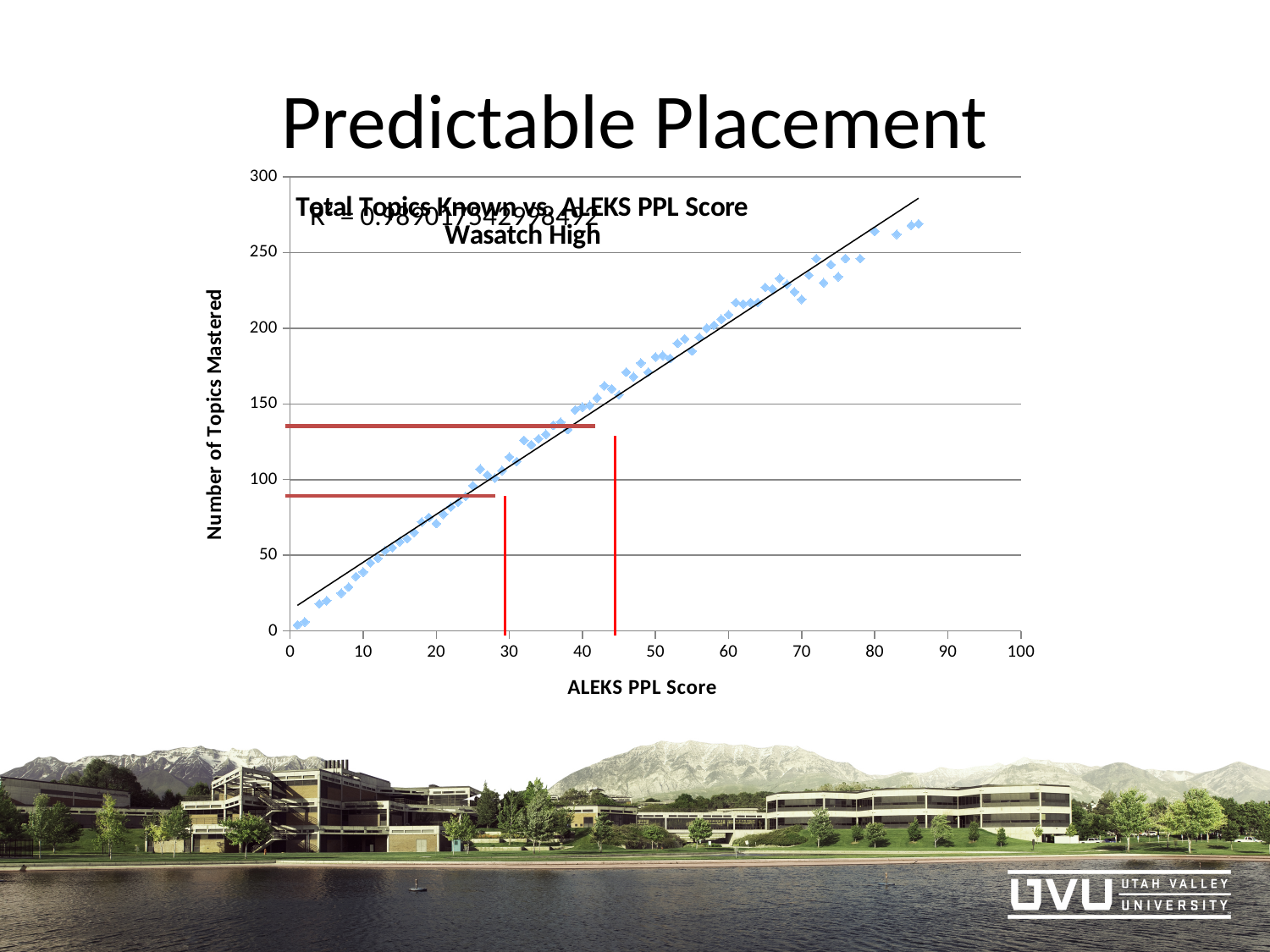
What is the label on the horizontal axis of the chart? ALEKS PPL Score Is the number of topics mastered for an ALEKS PPL Score of 50 greater or less than 150? greater Is the number of topics mastered for an ALEKS PPL Score of 80 greater or less than 250? greater Is the number of topics mastered for an ALEKS PPL Score of 20 greater or less than 100? less Which has more topics mastered: the points at an ALEKS PPL Score of 30 or the points at an ALEKS PPL Score of 70? 70 Do the plotted values rise or fall as the ALEKS PPL Score increases along the x axis? Rise What is the title of the chart? Total Topics Known vs. ALEKS PPL Score Wasatch High What is the maximum value shown on the vertical axis of the chart? 300 What kind of chart is shown on the slide? Scatter chart